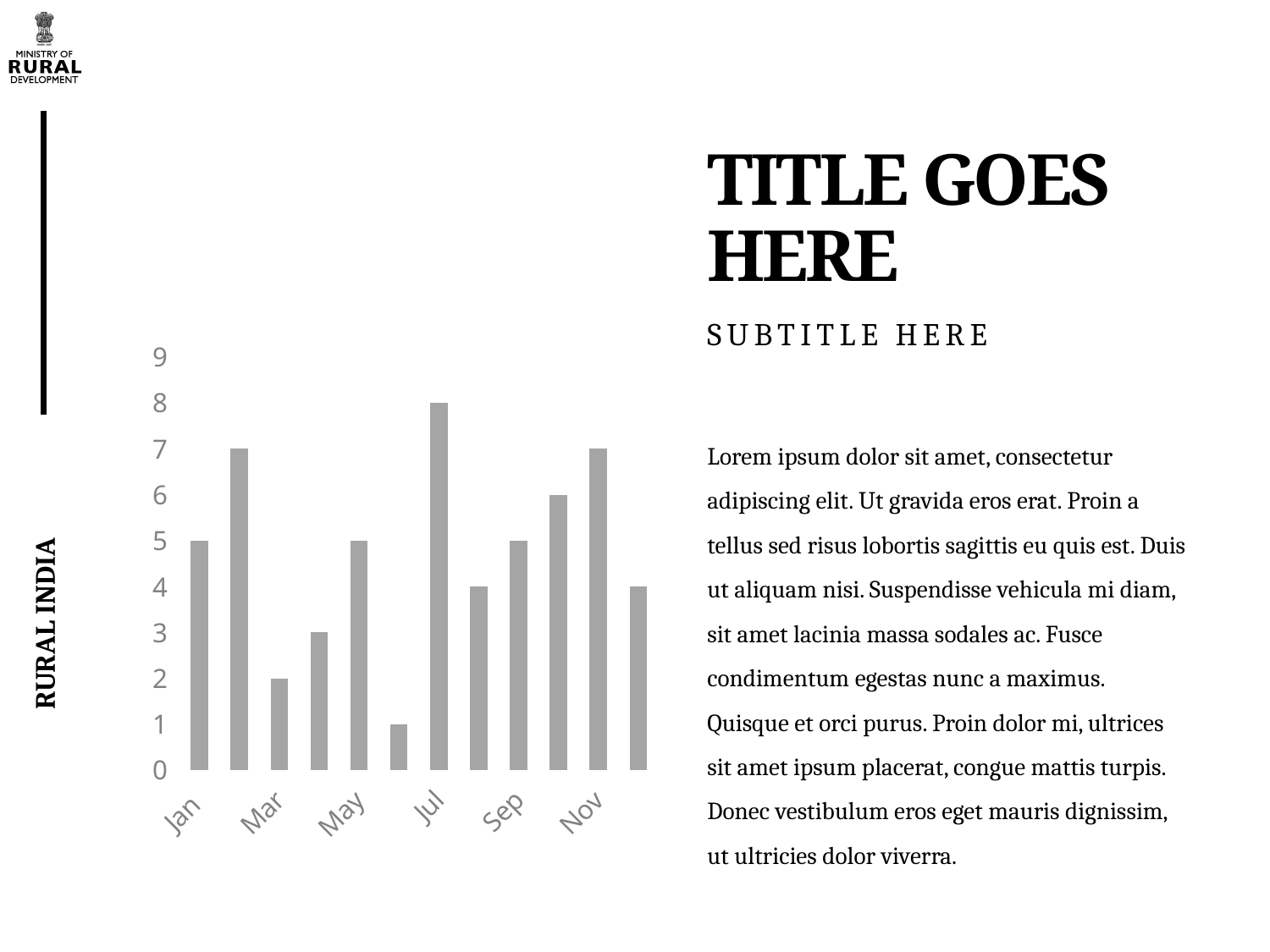
What is the value for Jan? 5 Which is larger, the value for Jan or the value for Mar? Jan Is the value for Nov greater or less than 5? greater How many bars are plotted in the chart? 12 What is the value for Nov? 7 What type of chart is shown on the slide? bar chart What is the value for Jul? 8 What is the highest value shown on the vertical axis? 9 What is the value for Mar? 2 What is the difference between the values for Jul and Mar? 6 Which month has the highest bar? Jul Is the value for Mar greater or less than 5? less